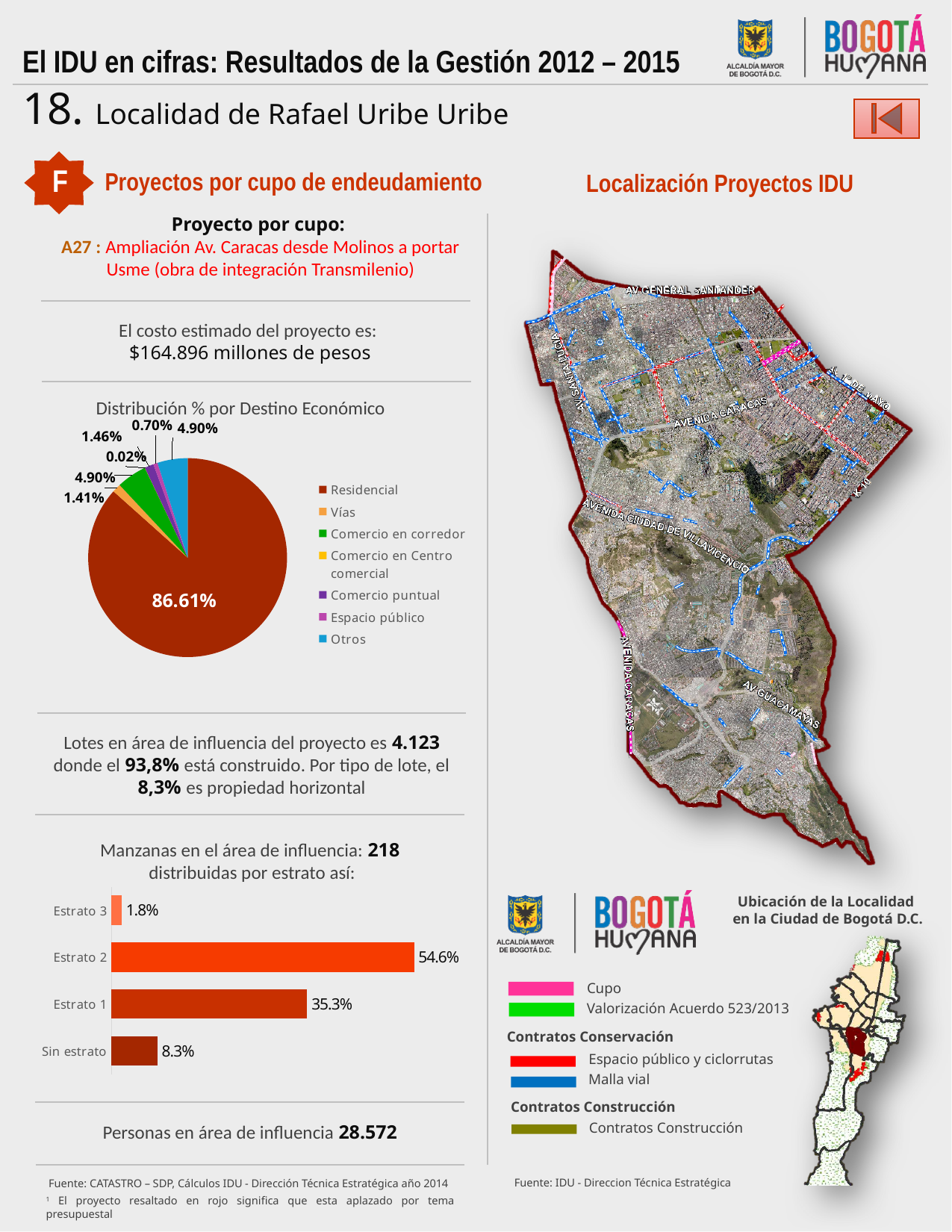
In the pie chart 'Distribución % por Destino Económico', which category has the largest slice? Residencial In the bar chart 'Manzanas en el área de influencia', which category has the highest value? Estrato 2 What type of chart is 'Manzanas en el área de influencia'? Bar chart In the pie chart 'Distribución % por Destino Económico', what share does Residencial have? 86.61% In the bar chart 'Manzanas en el área de influencia', what is the difference between Estrato 2 and Estrato 1? 19.3% In the pie chart 'Distribución % por Destino Económico', is the slice for Residencial larger or smaller than the slice for Otros? Larger In the bar chart 'Manzanas en el área de influencia', how many categories are shown? 4 In the bar chart 'Manzanas en el área de influencia', what is the value for Estrato 2? 54.6% How many entries does the legend of the pie chart 'Distribución % por Destino Económico' list? 7 In the bar chart 'Manzanas en el área de influencia', what is the value for Sin estrato? 8.3% In the bar chart 'Manzanas en el área de influencia', what is the value for Estrato 1? 35.3% In the bar chart 'Manzanas en el área de influencia', which category has the lowest value? Estrato 3